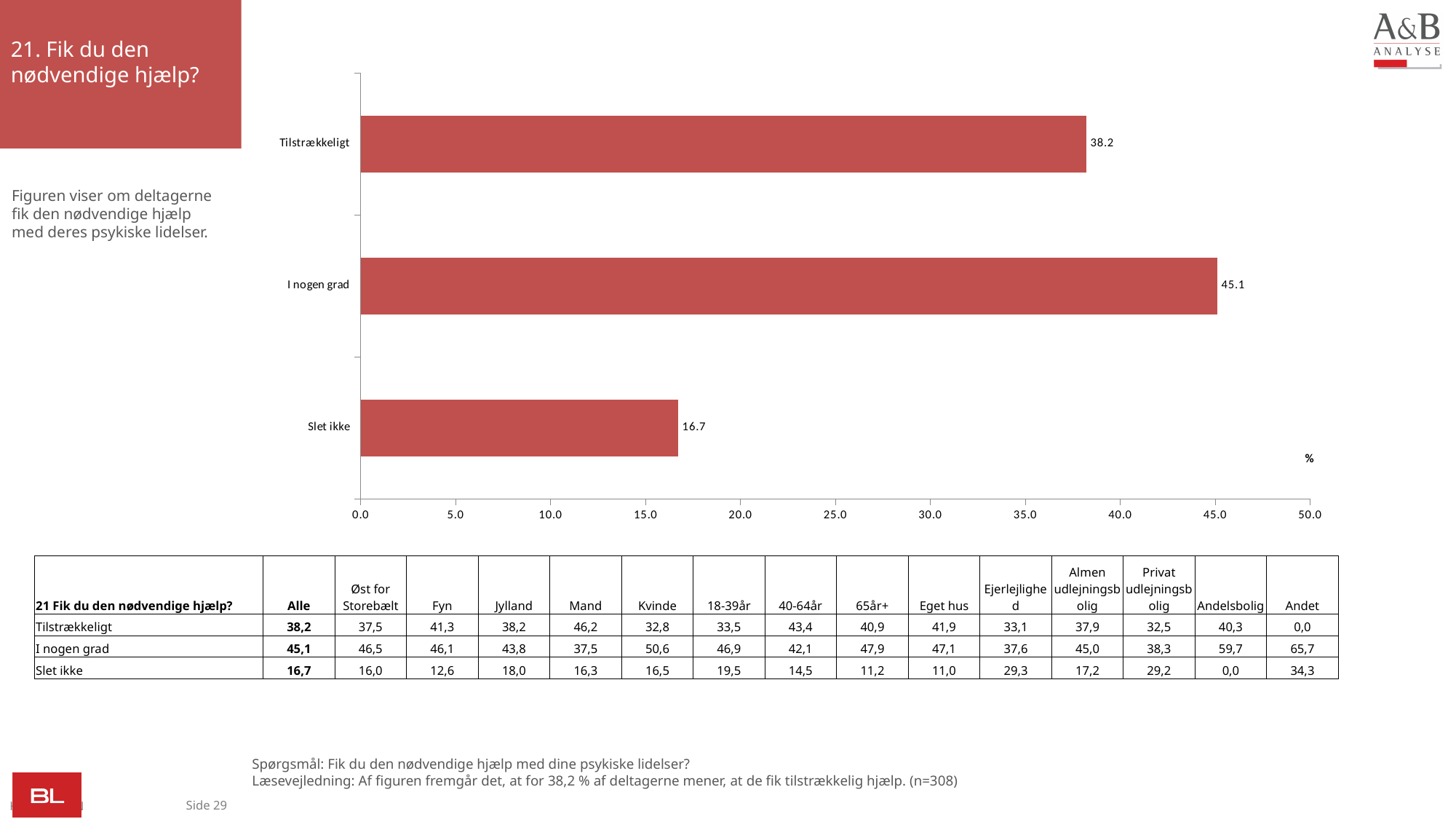
Which category has the highest value in the chart? I nogen grad How many categories are shown in the chart? 3 What is the maximum value shown on the horizontal axis of the chart? 50.0 What is the value for "Slet ikke" in the chart? 16.7 Which category has the lowest value in the chart? Slet ikke What is the value for "I nogen grad" in the chart? 45.1 Is the value for "I nogen grad" greater or less than 40.0? greater What is the value for "Tilstrækkeligt" in the chart? 38.2 What is the difference between the values for "Tilstrækkeligt" and "Slet ikke"? 21.5 Which is larger, the value for "Tilstrækkeligt" or the value for "Slet ikke"? Tilstrækkeligt What is the difference between the values for "I nogen grad" and "Tilstrækkeligt"? 6.9 What kind of chart is shown on the slide? Bar chart